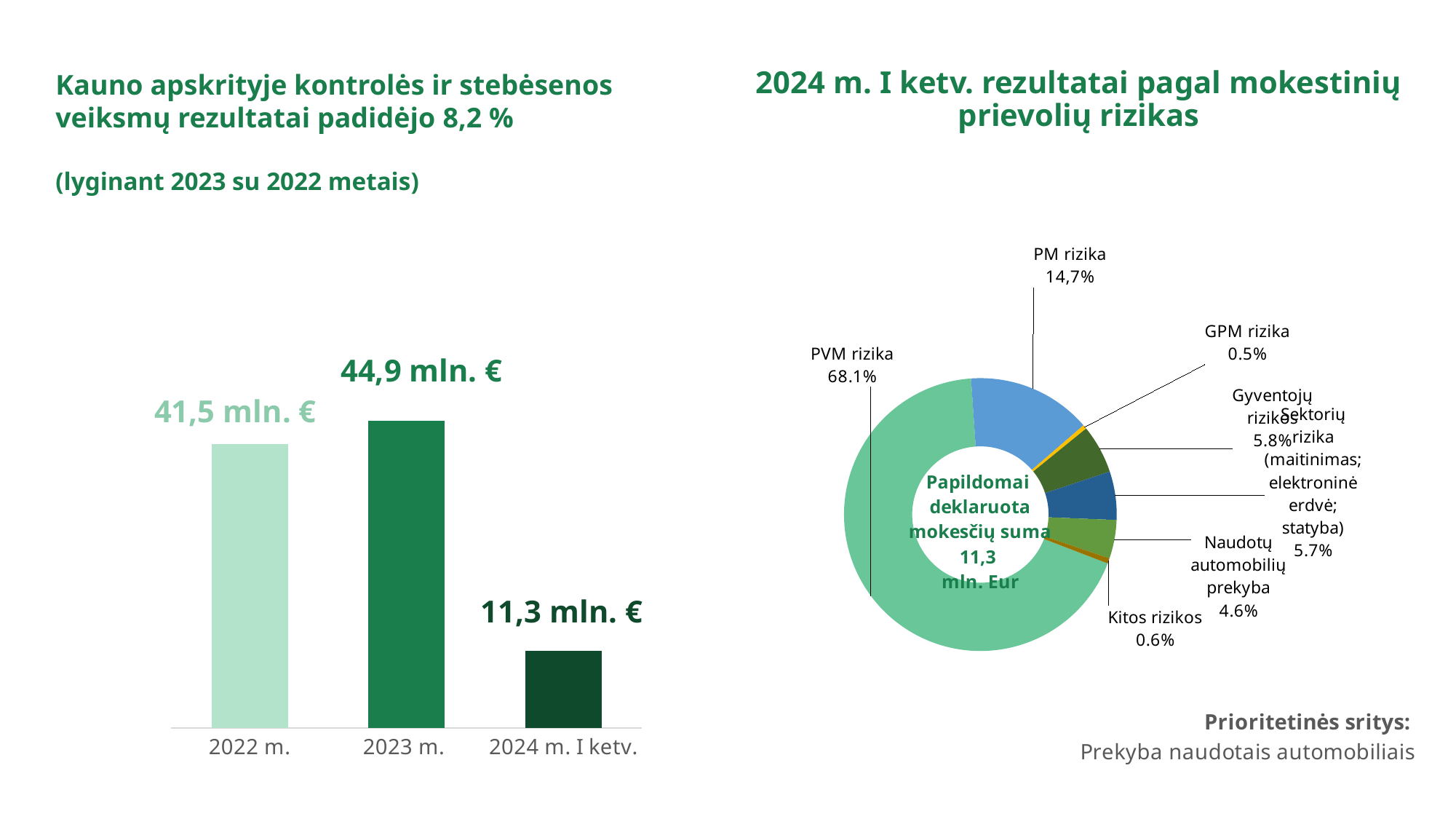
On the left bar chart, which category has the highest value? 2023 m. On the right doughnut chart, which is larger: Naudotų automobilių prekyba or Kitos rizikos? Naudotų automobilių prekyba On the left bar chart, what is the difference between the 2023 m. and 2022 m. values? 3,4 mln. € What kind of chart is on the left side of the slide? Bar chart On the right doughnut chart, what share does PVM rizika have? 68.1% On the left bar chart, which category has the lowest value? 2024 m. I ketv. On the left bar chart, what is the value for 2022 m.? 41,5 mln. € On the right doughnut chart, what share does PM rizika have? 14,7% What total amount is written in the centre of the right doughnut chart? 11,3 mln. Eur On the left bar chart, what is the value for 2023 m.? 44,9 mln. € On the right doughnut chart, which category has the smallest share? GPM rizika How many bars are shown on the left bar chart? 3